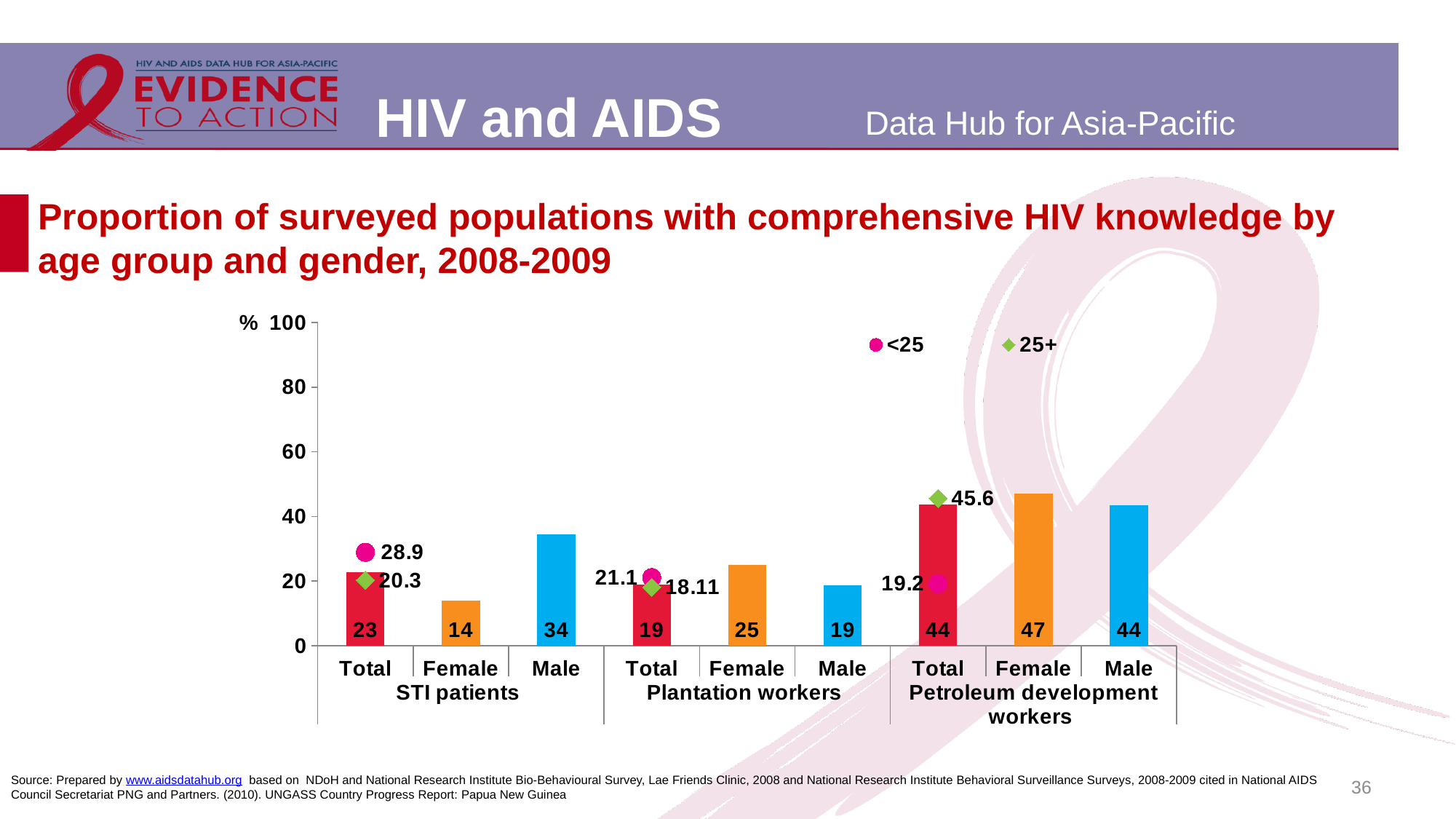
What is the <25 value for Total STI patients? 28.9 What is the difference between the Male and Female bars for STI patients? 20 Which bar has the lowest value on the chart? Female STI patients How many series does the legend list? 2 What is the 25+ value for Total Plantation workers? 18.11 What is the difference between the 25+ and <25 values for Total Petroleum development workers? 26.4 What is the value of the bar for Female STI patients? 14 Which is larger, the Female bar for Plantation workers or the Female bar for STI patients? Female bar for Plantation workers Is the value of the Total bar for Petroleum development workers greater or less than 40? greater What is the value of the bar for Male Petroleum development workers? 44 Which bar has the highest value on the chart? Female Petroleum development workers What type of chart is shown on the slide? Combination chart with bars and point markers (bar and line chart)